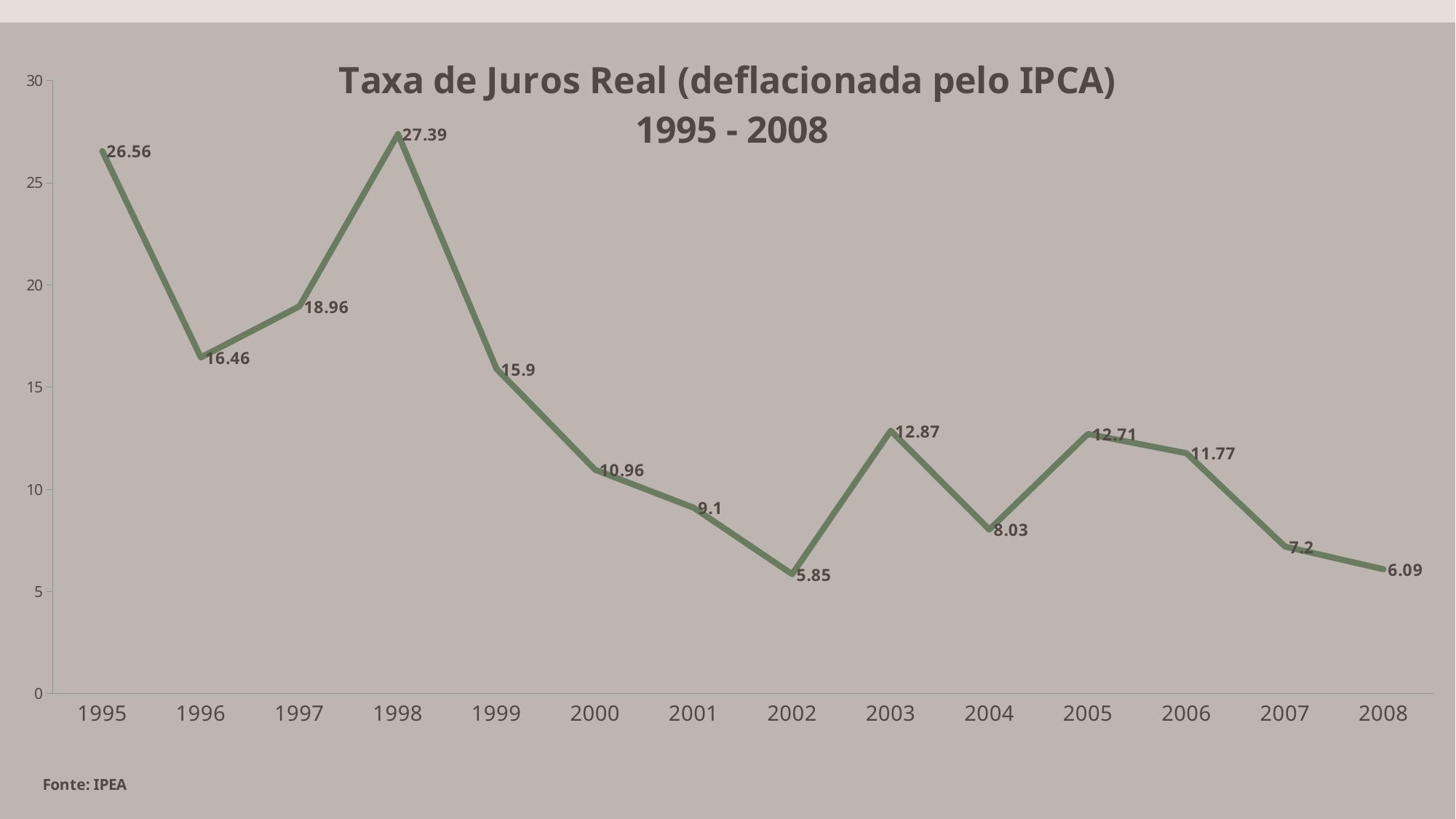
What is the real interest rate value for 1998? 27.39 Which year has a larger value, 2003 or 2006? 2003 How many years are plotted on the chart? 14 What is the value shown for 2002? 5.85 Is the value for 1999 greater or less than 15? greater What is the source cited for the chart? IPEA Which year has the highest real interest rate? 1998 What is the difference between the values for 1995 and 1996? 10.1 What kind of chart is shown on the slide? Line chart Which year has the lowest real interest rate? 2002 Does the value rise or fall from 2005 to 2008? Fall What is the value shown for 2005? 12.71